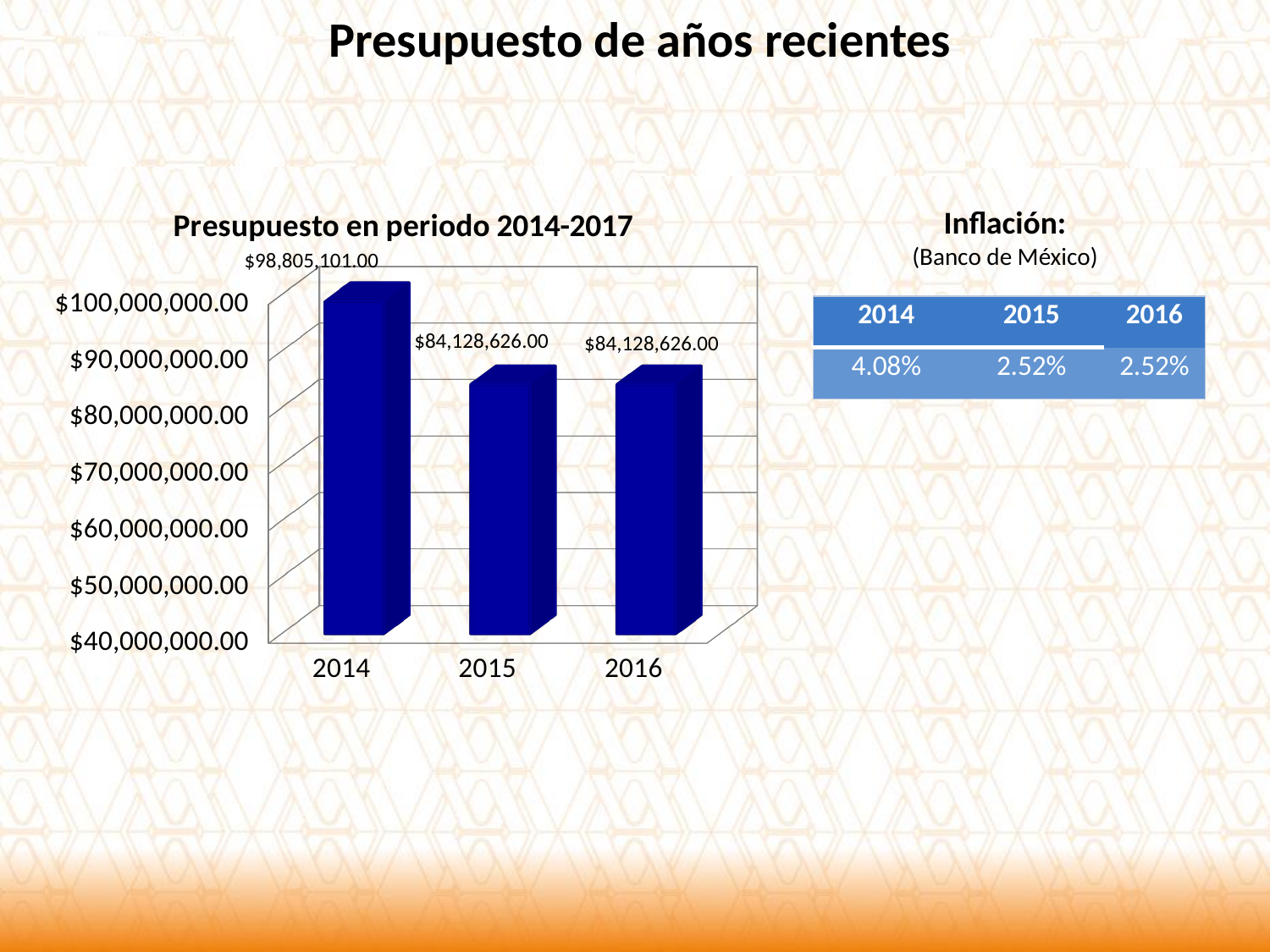
Are the budget values for 2015 and 2016 the same? Yes What is the budget value shown for 2014 in the chart? $98,805,101.00 How many years are shown on the x axis of the chart? 3 Is the budget value for 2014 greater or less than $90,000,000.00? greater What is the difference between the 2014 budget and the 2015 budget? $14,676,475.00 What kind of chart is used to show the budget? Bar chart Does the budget rise or fall from 2014 to 2015? Fall Which year has the larger budget, 2014 or 2016? 2014 What is the budget value shown for 2016 in the chart? $84,128,626.00 Is the budget value for 2015 greater or less than $90,000,000.00? less What is the budget value shown for 2015 in the chart? $84,128,626.00 Which year has the highest budget in the chart? 2014